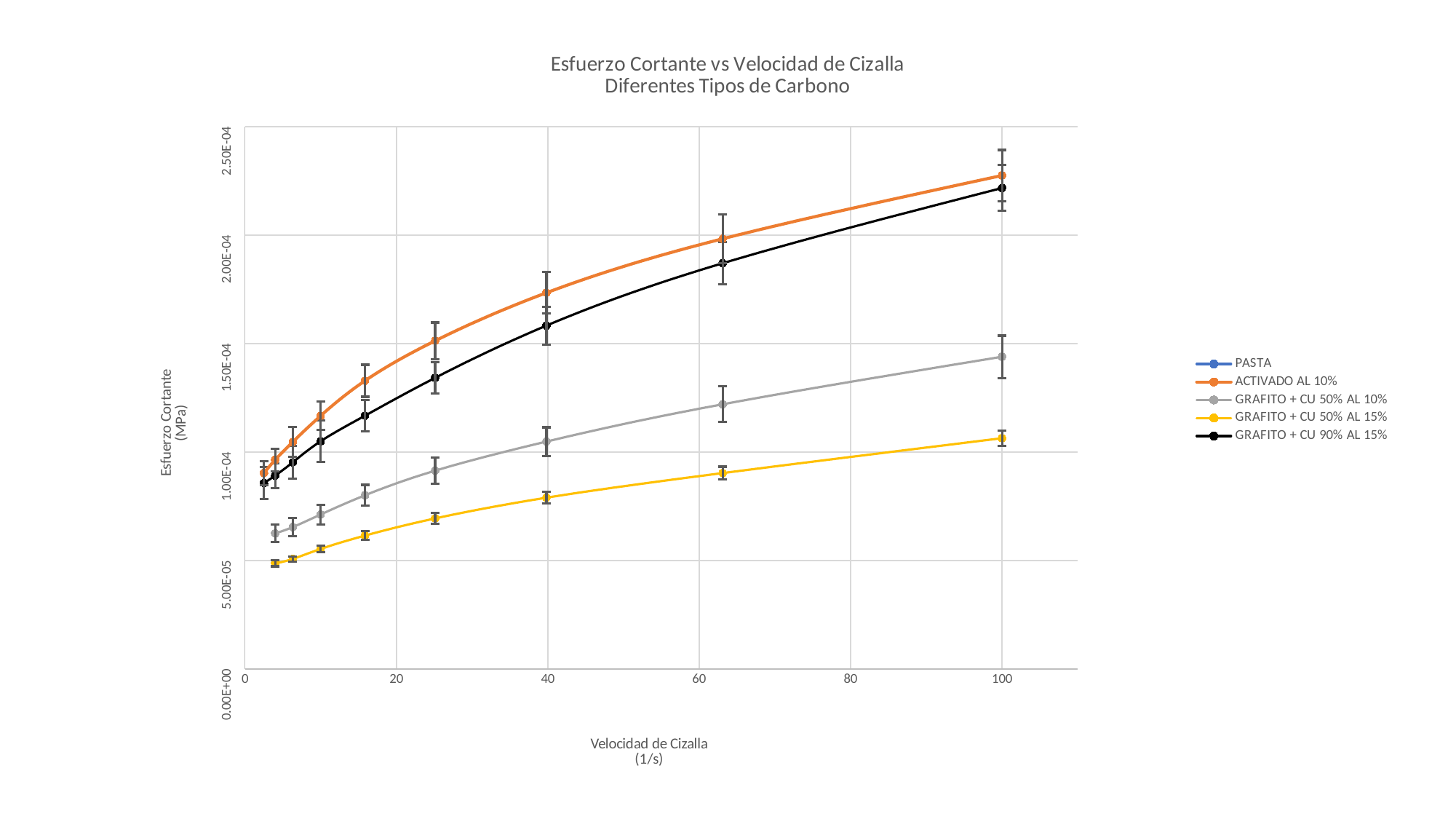
Which series has the highest value at Velocidad de Cizalla 100? ACTIVADO AL 10% At Velocidad de Cizalla 100, which is larger: ACTIVADO AL 10% or GRAFITO + CU 50% AL 10%? ACTIVADO AL 10% What kind of chart is shown on the slide? line chart How many series does the legend list? 5 Which plotted series has the lowest value at Velocidad de Cizalla 100? GRAFITO + CU 50% AL 15% What is the label of the x axis? Velocidad de Cizalla (1/s) Do the values for GRAFITO + CU 50% AL 15% rise or fall along the x axis? rise Is the value for GRAFITO + CU 50% AL 15% at Velocidad de Cizalla 40 greater or less than 1.00E-04? less Is the value for GRAFITO + CU 90% AL 15% at Velocidad de Cizalla 63 greater or less than 2.00E-04? less Is the value for ACTIVADO AL 10% at Velocidad de Cizalla 100 greater or less than 2.00E-04? greater Do the values for ACTIVADO AL 10% rise or fall as Velocidad de Cizalla increases? rise What is the title of the chart? Esfuerzo Cortante vs Velocidad de Cizalla Diferentes Tipos de Carbono